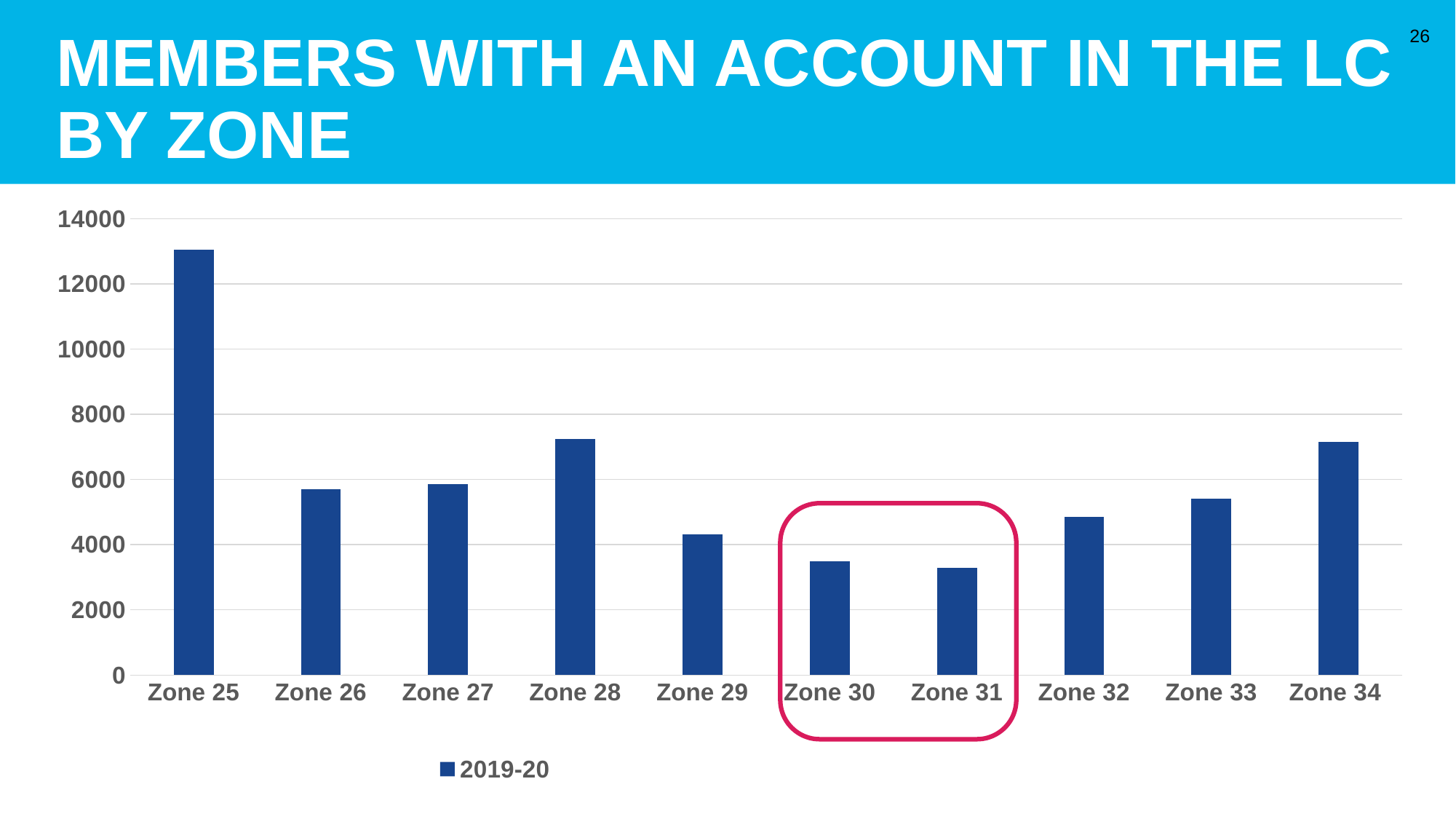
What kind of chart is shown on the slide? Bar chart Is the value for Zone 25 greater or less than 12000? greater Which has a larger value, Zone 25 or Zone 28? Zone 25 What series name is shown in the chart's legend? 2019-20 Is the value for Zone 30 greater or less than 4000? less How many zones are shown on the x axis of the chart? 10 How many series does the chart's legend list? 1 Which has a larger value, Zone 29 or Zone 32? Zone 32 Is the value for Zone 28 greater or less than 6000? greater Which zone has the highest number of members with an account in the LC? Zone 25